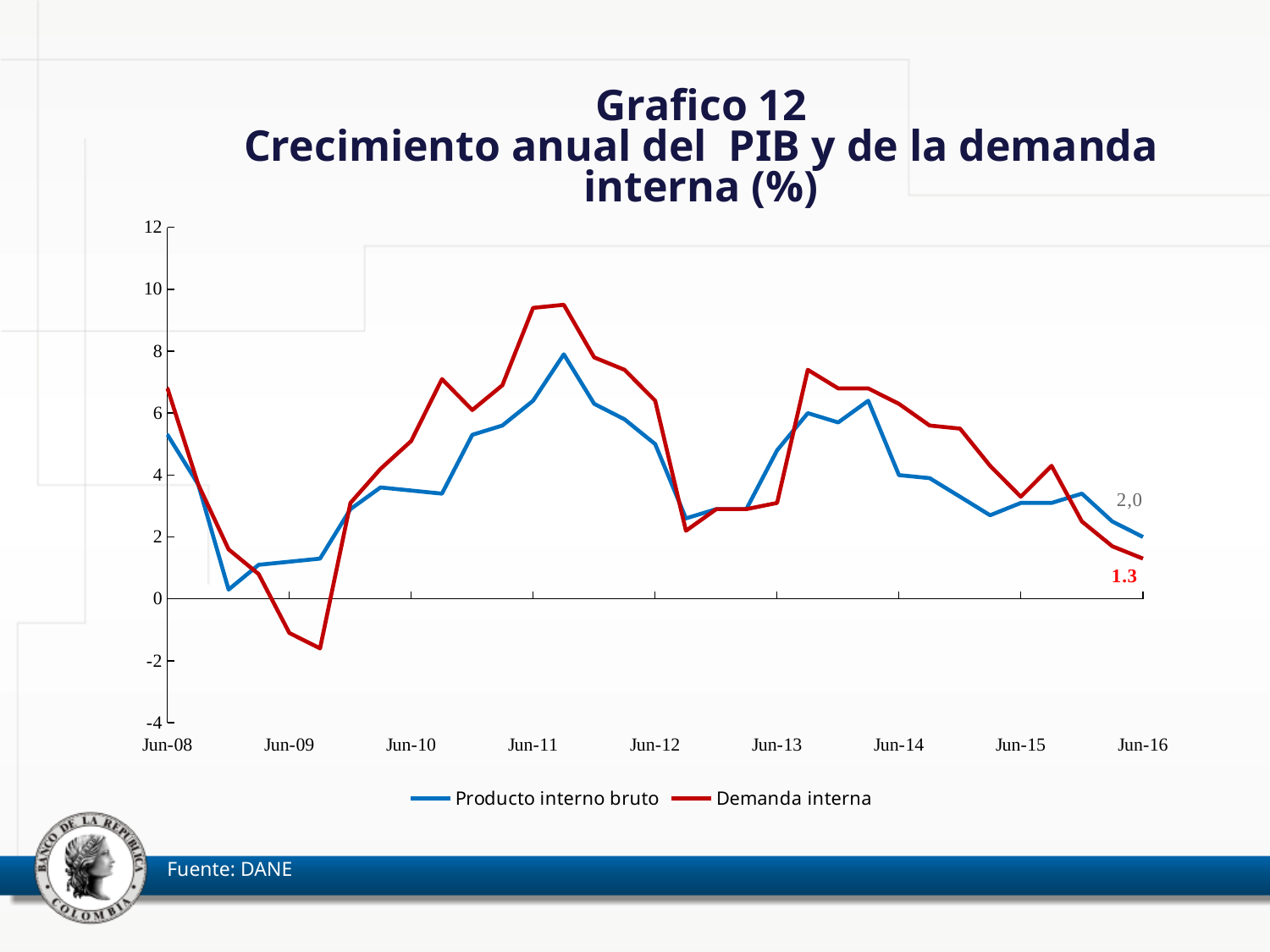
What is the labelled value of Demanda interna at Jun-16? 1.3 What kind of chart is shown on the slide? Line chart Does Producto interno bruto rise or fall between Jun-14 and Jun-16? Fall Is the value of Producto interno bruto at Jun-08 greater or less than 4? greater What is the difference between the Jun-16 values of Producto interno bruto (2,0) and Demanda interna (1.3)? 0.7 At Jun-16, which series has the higher value, Producto interno bruto or Demanda interna? Producto interno bruto Is the value of Demanda interna at Jun-11 greater or less than 8? greater Is the value of Demanda interna at Jun-09 greater or less than 0? less How many series does the legend list? 2 Which colour is used for the Demanda interna line? Red Which series reaches the highest peak over the whole period? Demanda interna What is the labelled value of Producto interno bruto at Jun-16? 2,0